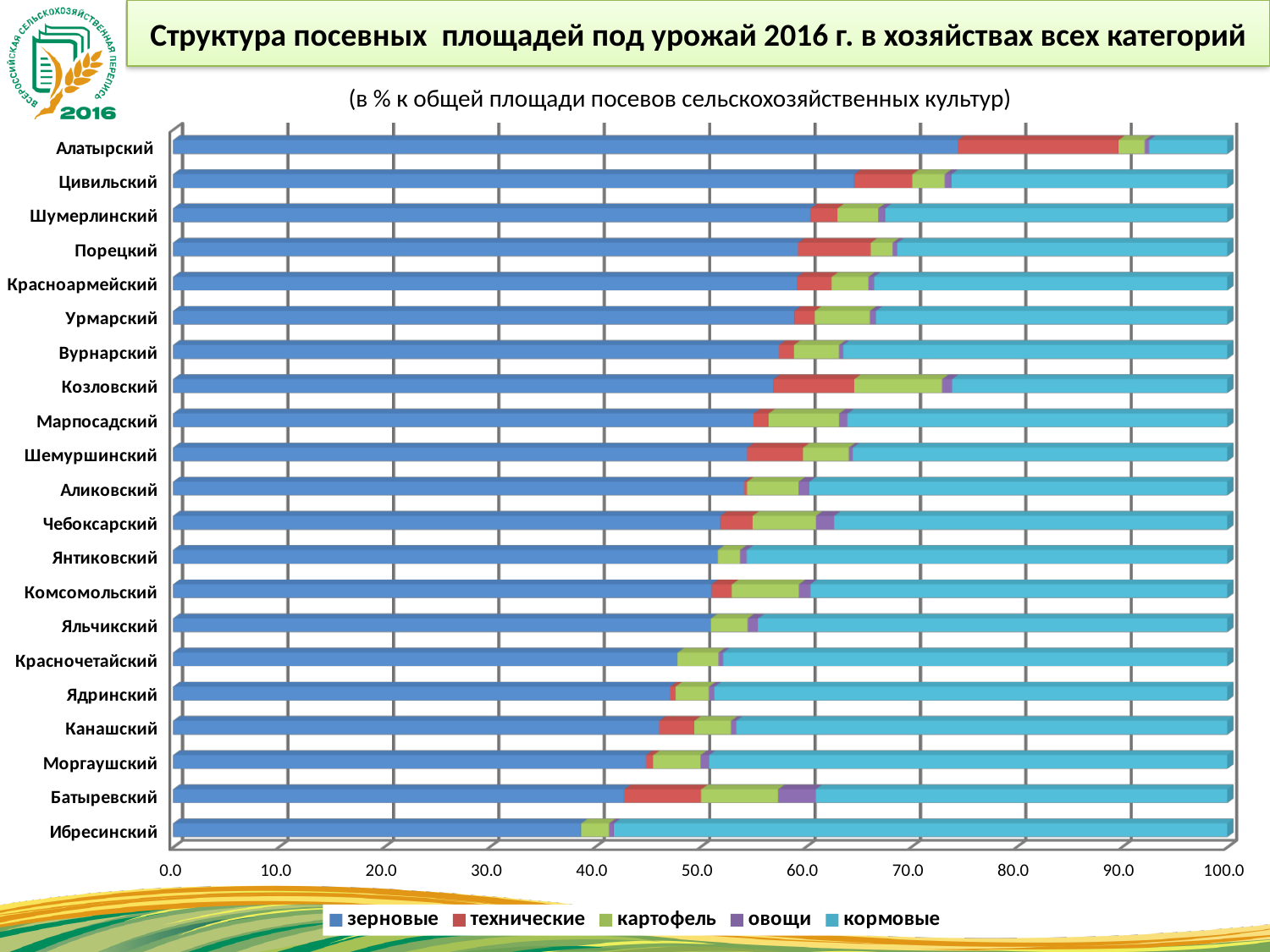
What kind of chart is shown on the slide? stacked bar chart Which district has the largest share of технические? Алатырский Which district has a larger share of картофель, Козловский or Янтиковский? Козловский How many districts (categories) are plotted on the chart? 21 Which district has the highest share of зерновые? Алатырский Is the share of зерновые for Батыревский greater or less than 50.0? less How many series does the legend list? 5 Which district has the largest share of овощи? Батыревский Which district has the lowest share of зерновые? Ибресинский Which series is listed first in the legend? зерновые Is the share of зерновые for Алатырский greater or less than 70.0? greater Is the share of зерновые for Ибресинский greater or less than 40.0? less